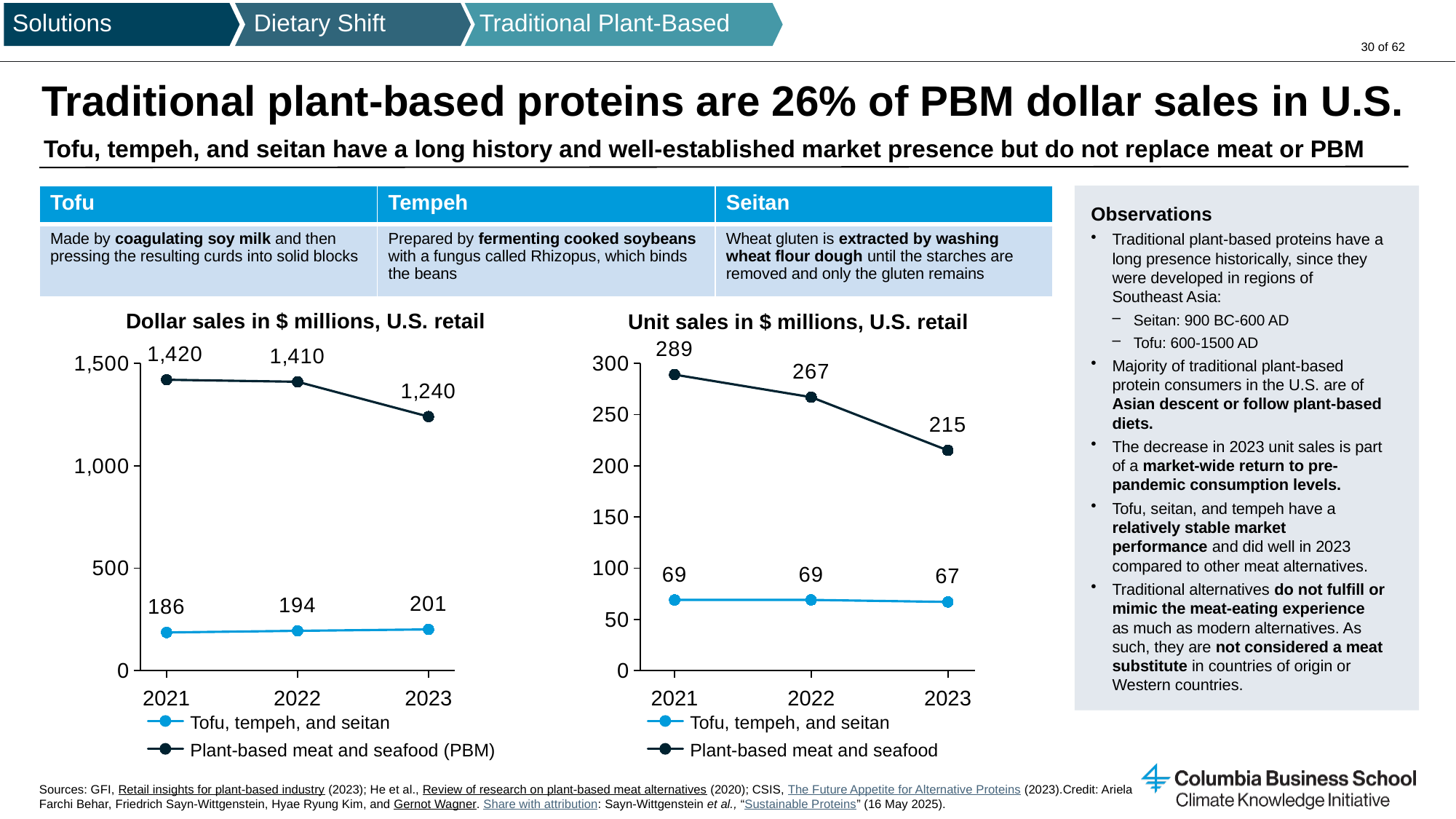
In the 'Dollar sales in $ millions, U.S. retail' chart, what is the value for Tofu, tempeh, and seitan in 2023? 201 In the 'Dollar sales in $ millions, U.S. retail' chart, in which year is the Plant-based meat and seafood (PBM) value lowest? 2023 How many series does the legend of the 'Dollar sales in $ millions, U.S. retail' chart list? 2 What kind of chart is the 'Unit sales in $ millions, U.S. retail' chart? line chart In the 'Unit sales in $ millions, U.S. retail' chart, does the Plant-based meat and seafood series rise or fall from 2021 to 2023? fall In the 'Dollar sales in $ millions, U.S. retail' chart, does the Tofu, tempeh, and seitan series rise or fall from 2021 to 2023? rise In the 'Unit sales in $ millions, U.S. retail' chart, in which year is the Plant-based meat and seafood value highest? 2021 In the 'Dollar sales in $ millions, U.S. retail' chart, what is the difference between the Plant-based meat and seafood (PBM) values in 2022 and 2023? 170 In the 'Dollar sales in $ millions, U.S. retail' chart, what is the value for Plant-based meat and seafood (PBM) in 2021? 1,420 In the 'Unit sales in $ millions, U.S. retail' chart, what is the value for Tofu, tempeh, and seitan in 2023? 67 In the 'Unit sales in $ millions, U.S. retail' chart, what is the difference between the Plant-based meat and seafood values in 2021 and 2023? 74 In the 'Unit sales in $ millions, U.S. retail' chart, what is the value for Plant-based meat and seafood in 2022? 267